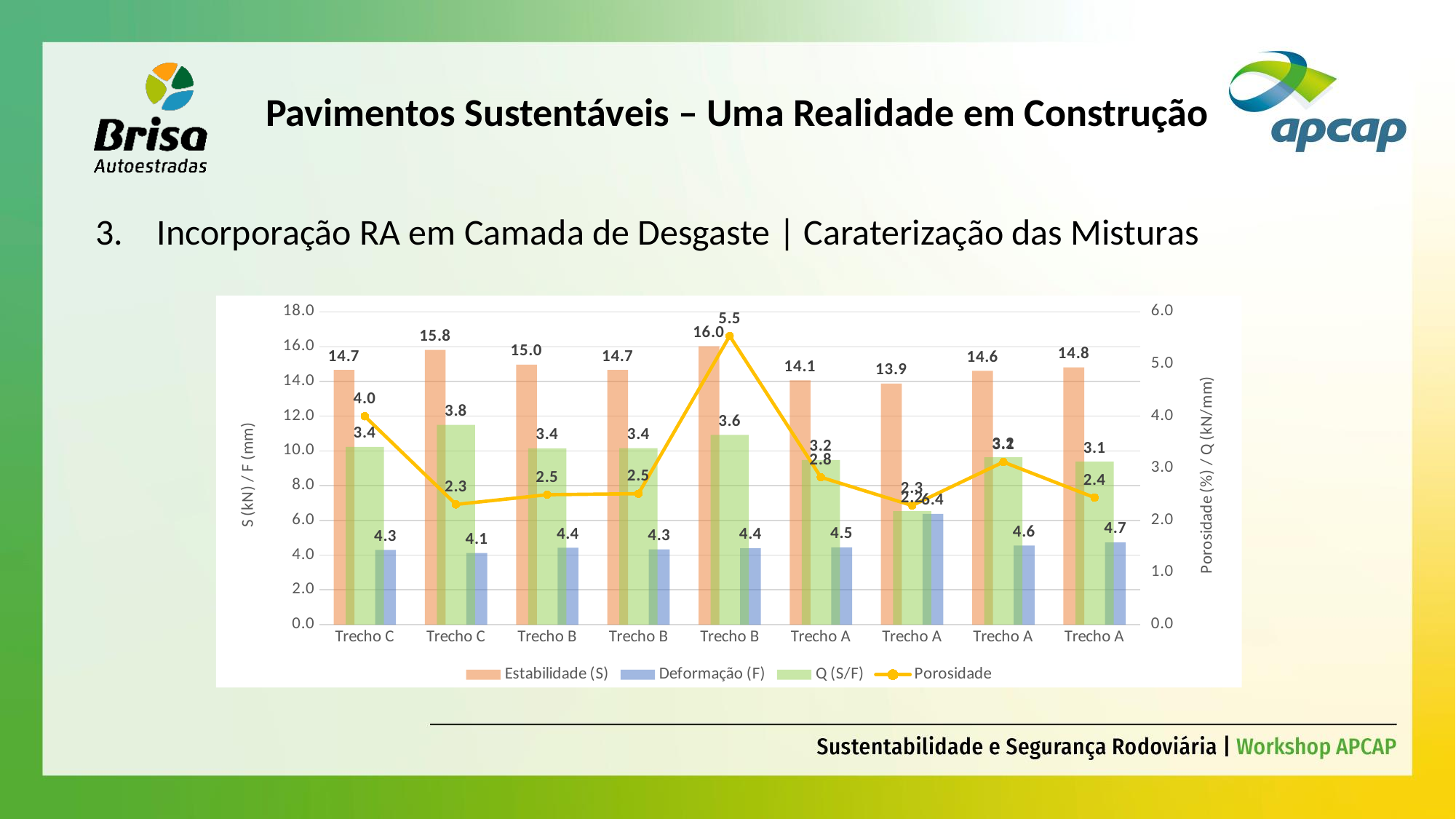
What is the label of the right-hand vertical axis? Porosidade (%) / Q (kN/mm) Which has the larger Estabilidade (S): the first Trecho C group or the second Trecho C group? The second Trecho C group (15.8) What is the Deformação (F) value for the last group on the right (Trecho A)? 4.7 How many series does the legend list? 4 What is the highest Estabilidade (S) value shown, and which group has it? 16.0, the fifth group (Trecho B) What kind of chart is shown on the slide? A bar chart combined with a line What is the lowest Estabilidade (S) value shown? 13.9 What is the highest Porosidade value on the line? 5.5 What is the Estabilidade (S) value for the second group from the left (Trecho C)? 15.8 What is the Porosidade value for the first group on the left (Trecho C)? 4.0 How many category groups are plotted along the x axis? 9 What is the difference between the highest and lowest Estabilidade (S) values? 2.1